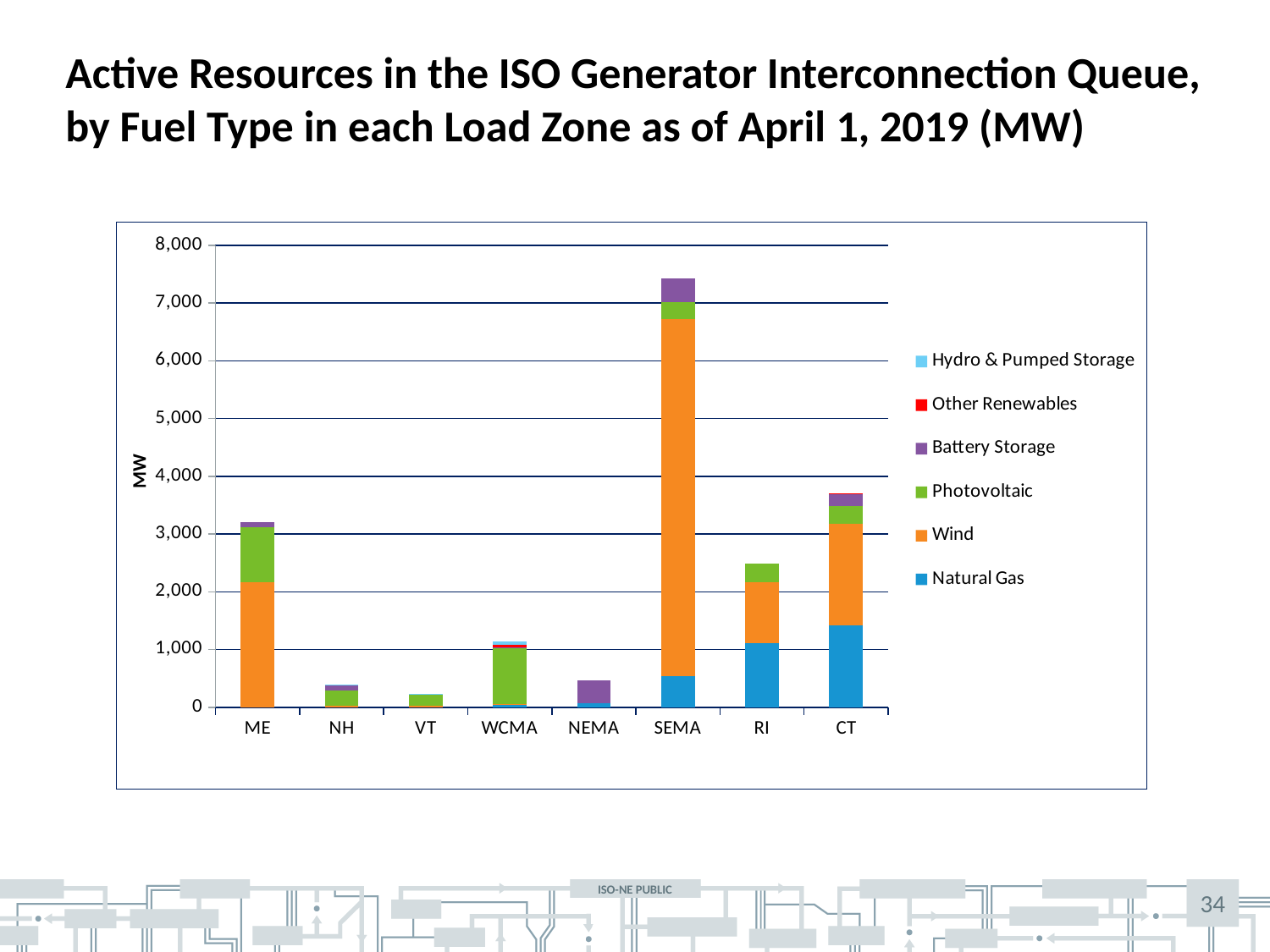
Is the total value for RI greater or less than 3,000? less What kind of chart is shown on the slide? Stacked bar chart Which load zone has the highest total MW in the queue? SEMA What is the label on the y axis of the chart? MW Is the total value for NEMA greater or less than 1,000? less How many load zones are shown on the x axis of the chart? 8 Is the total value for CT greater or less than 3,000? greater Which load zone has the lowest total MW in the queue? VT How many fuel-type series does the legend list? 6 Which load zone has a larger total, CT or RI? CT Which fuel type is shown in orange in the legend? Wind